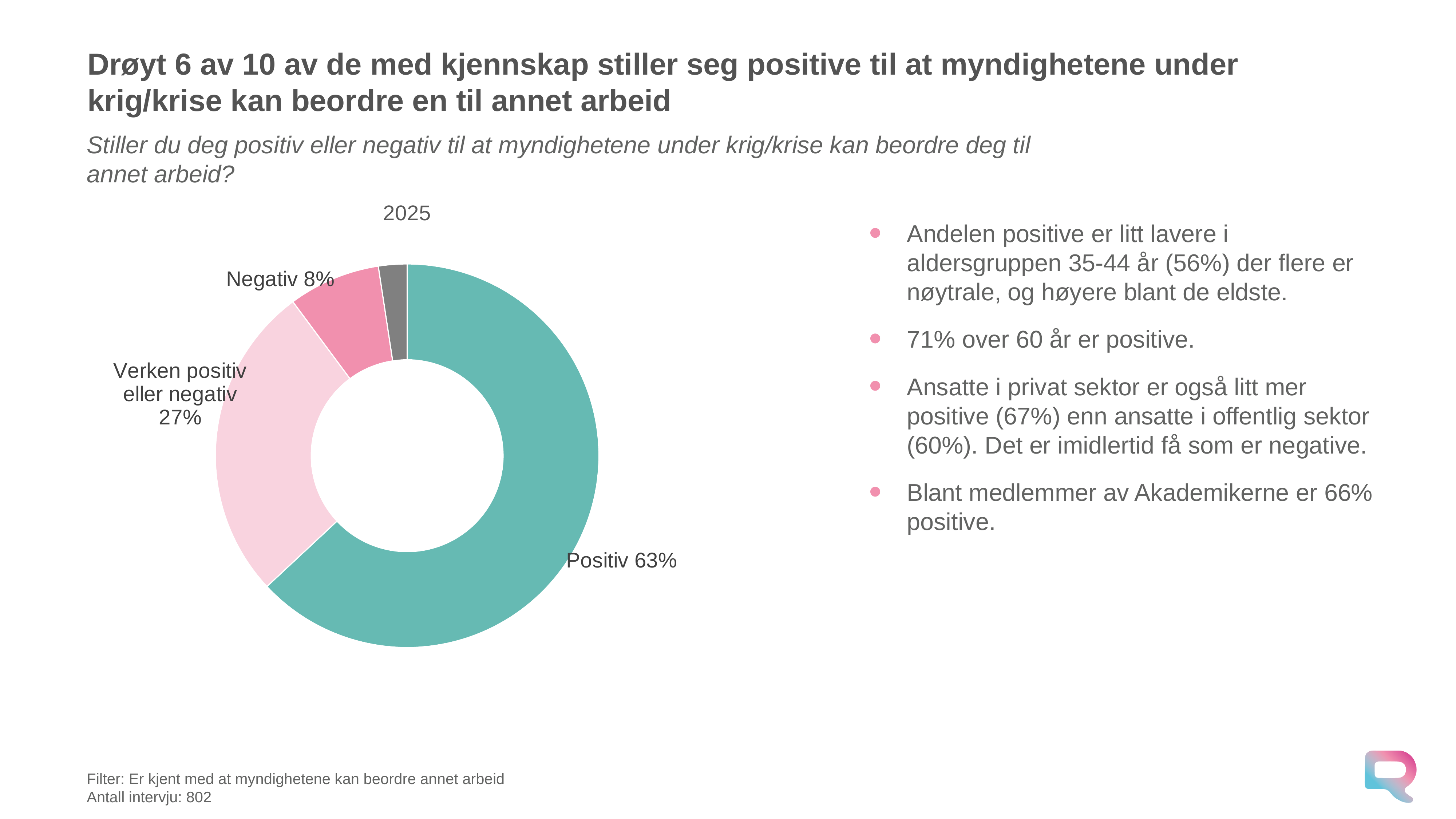
Which is larger, the share for Negativ or the share for Verken positiv eller negativ? Verken positiv eller negativ What is the value for Verken positiv eller negativ in the chart? 27% What is the difference in percentage points between Verken positiv eller negativ and Negativ? 19 percentage points Which labelled category has the smallest share of the chart? Negativ What year is shown as the title above the chart? 2025 What is the value for Positiv in the chart? 63% What kind of chart is shown on the slide? Donut (pie) chart What colour is the Positiv slice in the chart? Teal (green) What share of the chart does the Positiv slice represent? 63% What is the difference in percentage points between Positiv and Verken positiv eller negativ? 36 percentage points Which labelled category has the largest share of the chart? Positiv What is the value for Negativ in the chart? 8%